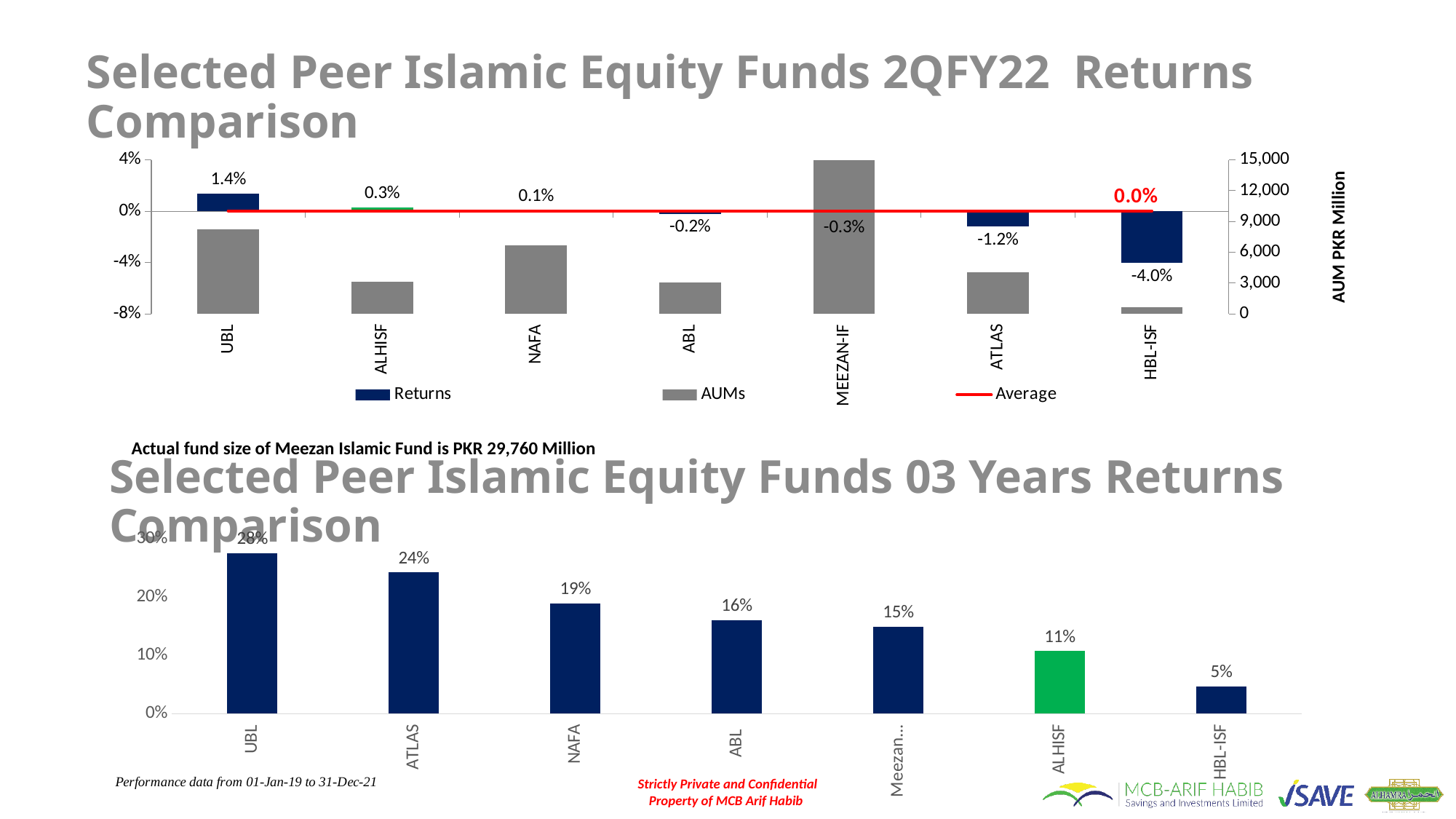
In the 03 Years Returns Comparison chart, what is the return for NAFA? 19% In the 2QFY22 Returns Comparison chart, what value is labelled on the Average line? 0.0% In the 03 Years Returns Comparison chart, how many funds are shown? 7 In the 2QFY22 Returns Comparison chart, what is the difference between the returns of UBL and ATLAS? 2.6% In the 2QFY22 Returns Comparison chart, what is the return for UBL? 1.4% In the 2QFY22 Returns Comparison chart, which fund has the lowest return? HBL-ISF In the 2QFY22 Returns Comparison chart, what is the return for HBL-ISF? -4.0% In the 03 Years Returns Comparison chart, do the values rise or fall from left to right? fall In the 2QFY22 Returns Comparison chart, how many series does the legend list? 3 In the 03 Years Returns Comparison chart, which fund has the highest return? UBL In the 2QFY22 Returns Comparison chart, is the AUM for MEEZAN-IF greater or less than 12,000? greater In the 03 Years Returns Comparison chart, what is the difference between the returns of ATLAS and ALHISF? 13%